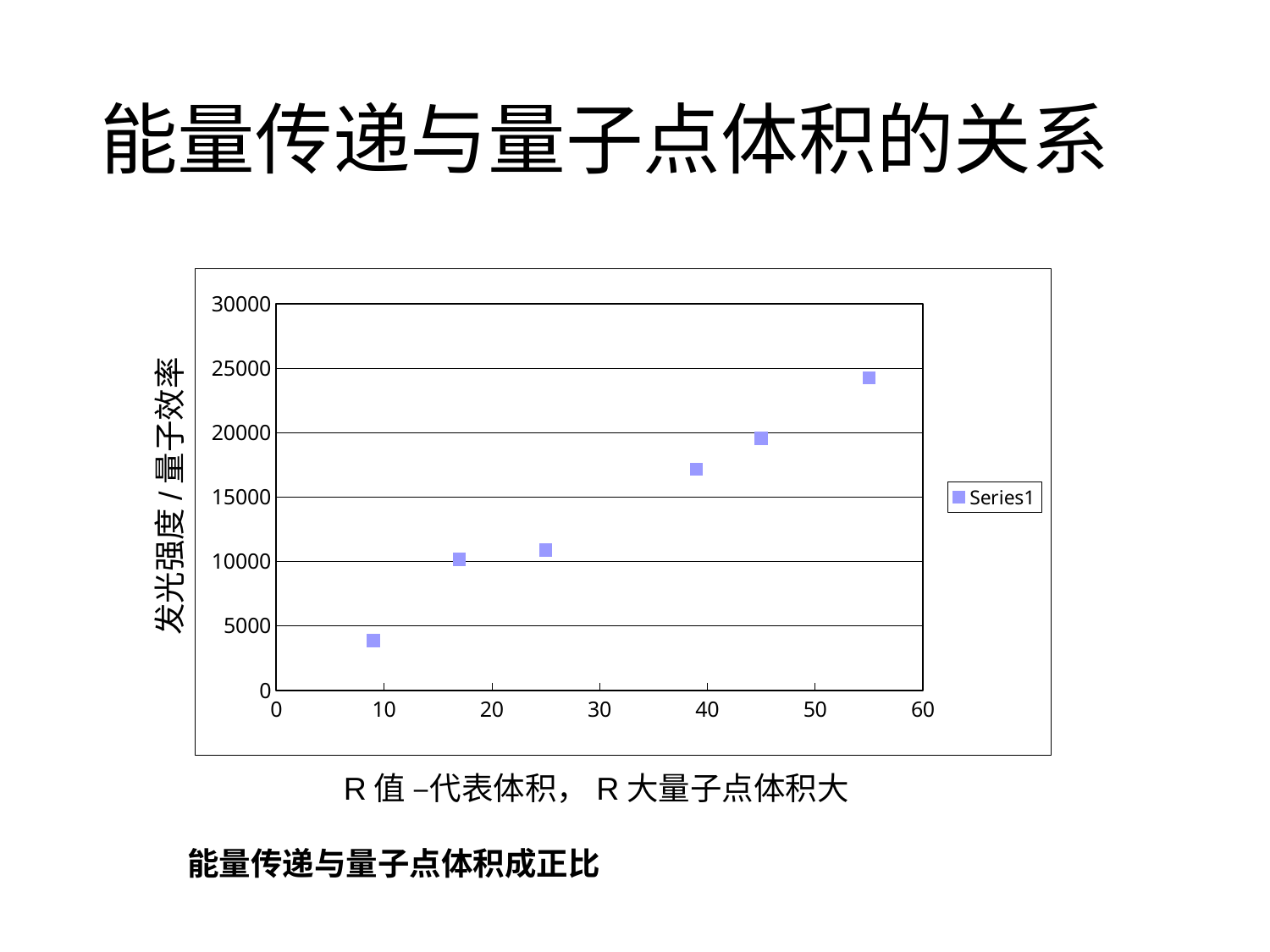
Is the value of the point near x = 39 greater or less than 15000? greater Is the value of the leftmost point (near x = 9) greater or less than 5000? less How many series does the chart legend list? 1 Which point has the highest value: the one near x = 9 or the one near x = 55? the one near x = 55 What is the name of the series shown in the chart legend? Series1 Which point has the larger value: the one near x = 25 or the one near x = 39? the one near x = 39 Do the plotted values rise or fall as the x value increases? rise What kind of chart is shown on the slide? scatter chart What is the label on the vertical axis of the chart? 发光强度 / 量子效率 Is the value of the point near x = 25 greater or less than 15000? less How many data points are plotted in the chart? 6